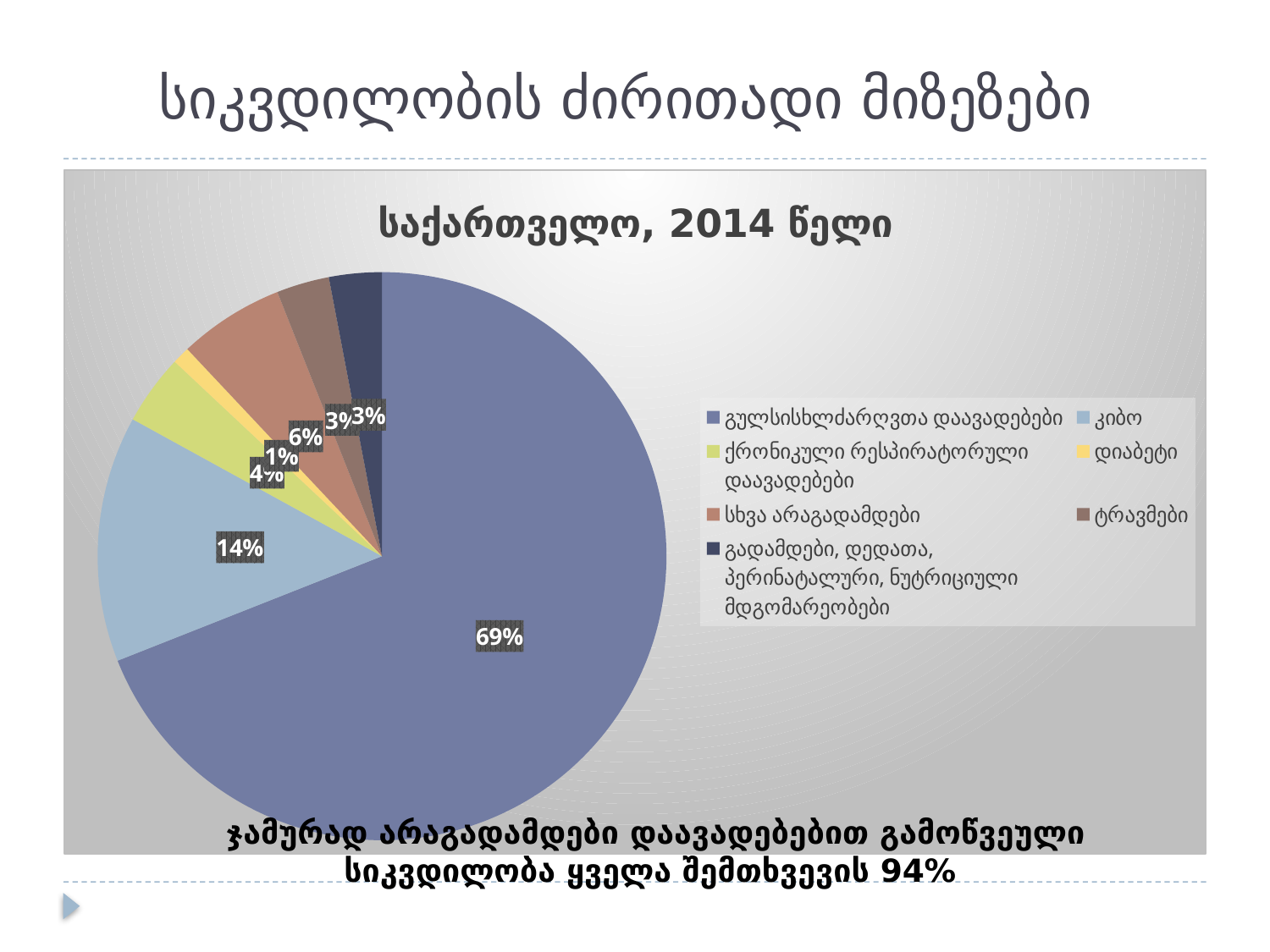
Which is larger, the share for სხვა არაგადამდები or the share for ტრავმები? სხვა არაგადამდები What is the value for ქრონიკული რესპირატორული დაავადებები? 4% What share of the pie is გულსისხლძარღვთა დაავადებები? 69% How many slices does the pie chart have? 7 What is the difference between the shares of გულსისხლძარღვთა დაავადებები and კიბო? 55% Which category has the smallest slice of the pie? დიაბეტი What is the value for დიაბეტი? 1% What is the value for სხვა არაგადამდები? 6% What is the title of the chart? საქართველო, 2014 წელი What type of chart is shown on the slide? pie chart Which category has the largest slice of the pie? გულსისხლძარღვთა დაავადებები What share of the pie is კიბო? 14%